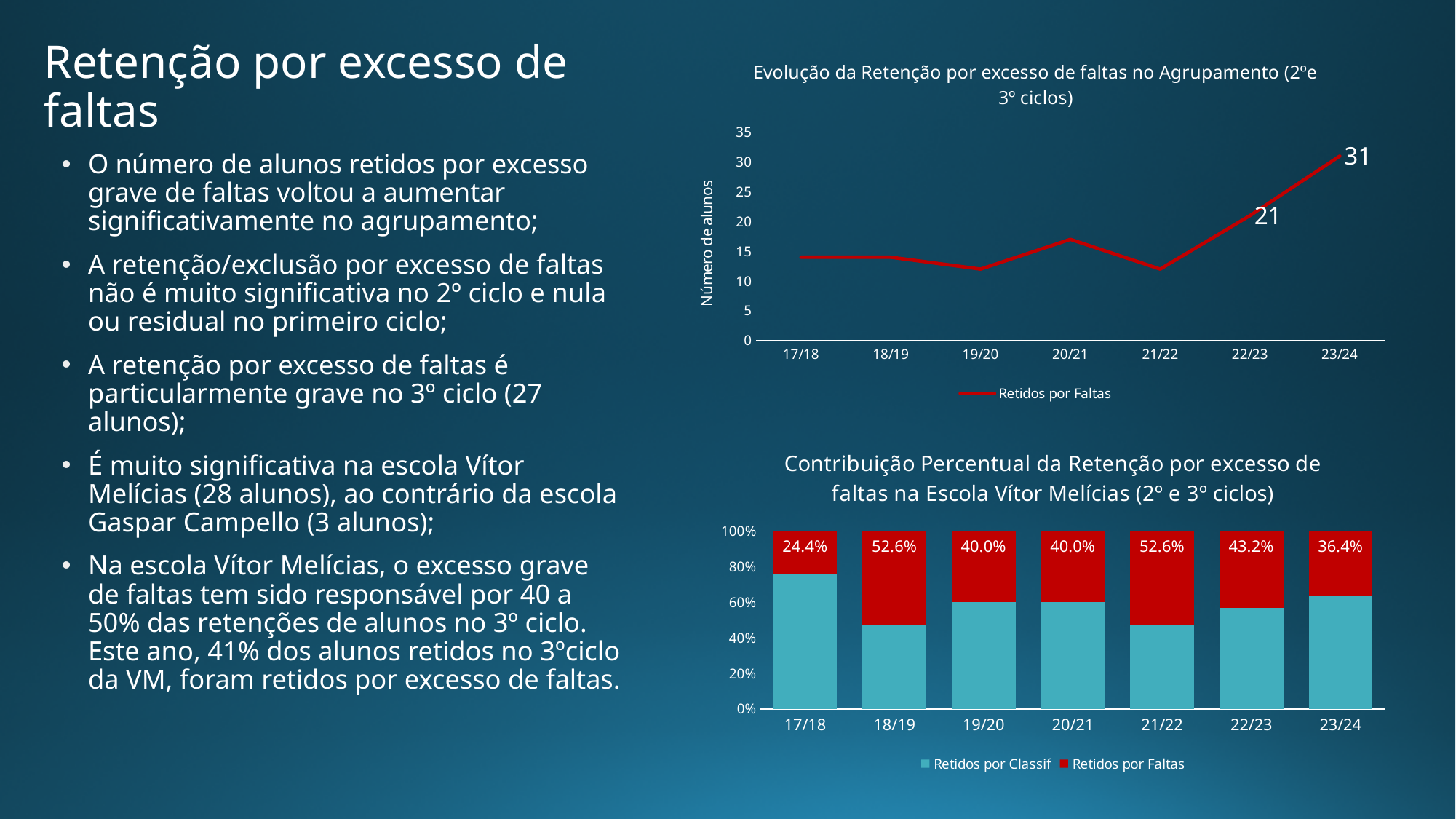
In the bottom chart (Contribuição Percentual da Retenção por excesso de faltas na Escola Vítor Melícias), what is the Retidos por Faltas value for 23/24? 36.4% In the top chart (Evolução da Retenção por excesso de faltas no Agrupamento), which year has the highest value? 23/24 In the top chart (Evolução da Retenção por excesso de faltas no Agrupamento), how many school years are plotted on the x axis? 7 In the bottom chart (Contribuição Percentual da Retenção por excesso de faltas na Escola Vítor Melícias), which year has the lowest Retidos por Faltas percentage? 17/18 How many series does the legend of the bottom chart (Contribuição Percentual da Retenção por excesso de faltas na Escola Vítor Melícias) list? 2 In the bottom chart (Contribuição Percentual da Retenção por excesso de faltas na Escola Vítor Melícias), which year has the larger Retidos por Faltas percentage, 22/23 or 23/24? 22/23 In the top chart (Evolução da Retenção por excesso de faltas no Agrupamento), what is the value for 22/23? 21 In the top chart (Evolução da Retenção por excesso de faltas no Agrupamento), what is the value for 23/24? 31 In the top chart (Evolução da Retenção por excesso de faltas no Agrupamento), what is the difference between the values for 23/24 and 22/23? 10 What kind of chart is the top chart (Evolução da Retenção por excesso de faltas no Agrupamento)? Line chart In the bottom chart (Contribuição Percentual da Retenção por excesso de faltas na Escola Vítor Melícias), what is the Retidos por Faltas value for 18/19? 52.6% In the top chart (Evolução da Retenção por excesso de faltas no Agrupamento), is the value for 19/20 greater or less than 15? less